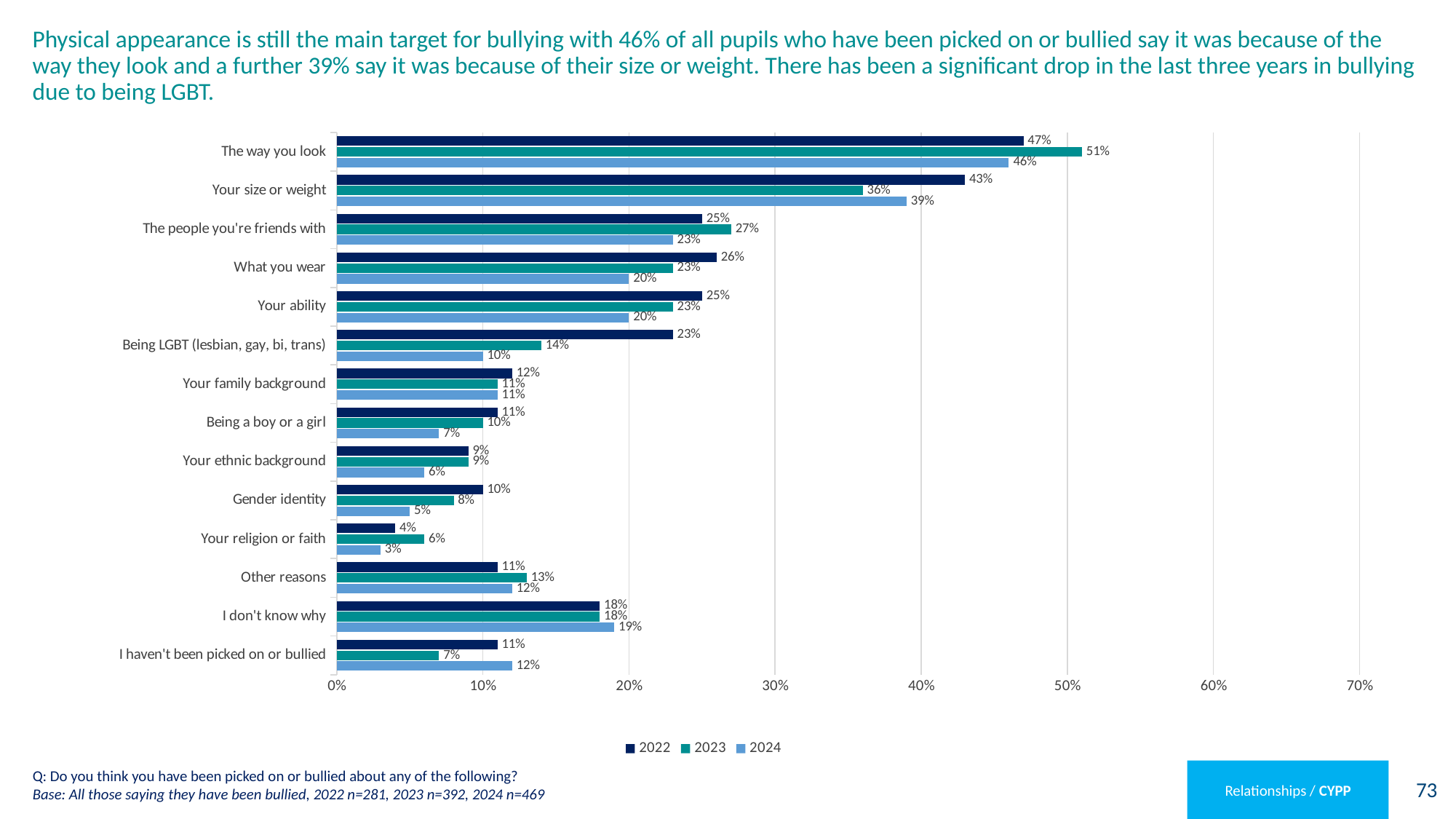
Which is larger for 'Your size or weight': the 2022 value or the 2024 value? 2022 Which category has the highest 2023 value? The way you look What is the difference between the 2022 and 2024 values for 'Being LGBT (lesbian, gay, bi, trans)'? 13% What is the 2023 value for 'Your size or weight'? 36% How many series does the legend list? 3 What is the 2022 value for 'Being LGBT (lesbian, gay, bi, trans)'? 23% How many categories are shown on the chart? 14 Which category has the lowest 2024 value? Your religion or faith Which series does the legend list first? 2022 What is the 2024 value for 'The way you look'? 46% What kind of chart is shown on the slide? Bar chart Is the 2023 value for 'The way you look' greater or less than 50%? greater